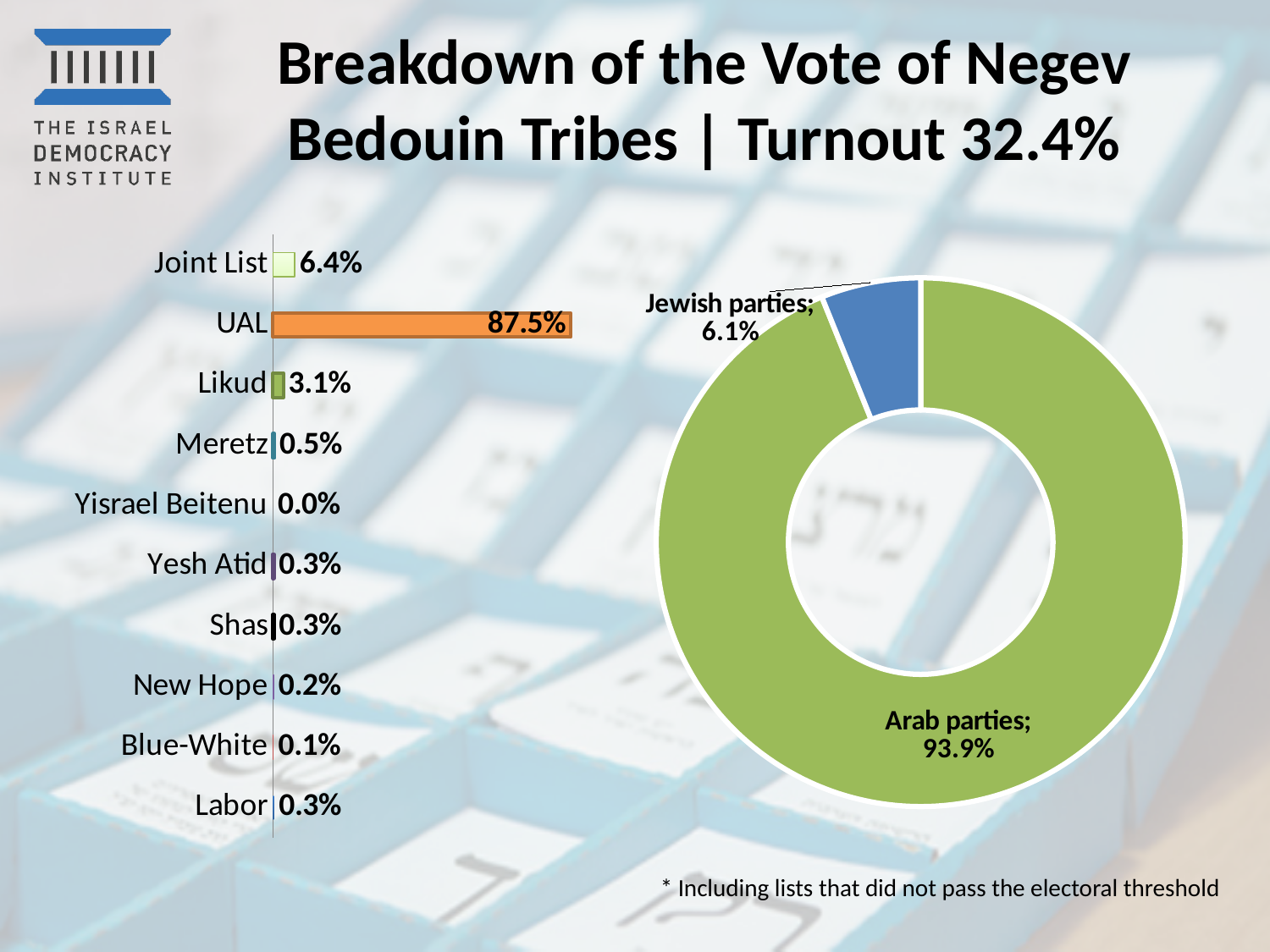
In the donut chart on the right, what share of the vote went to Jewish parties? 6.1% In the bar chart on the left, what is the value for Likud? 3.1% What kind of chart is on the left side of the slide? Bar chart How many parties are shown in the bar chart on the left? 10 What is the turnout figure given in the slide title? 32.4% In the donut chart on the right, what share of the vote went to Arab parties? 93.9% In the bar chart on the left, what is the value for Joint List? 6.4% In the bar chart on the left, what is the value for UAL? 87.5% In the bar chart on the left, what is the difference between the values for UAL and Joint List? 81.1% In the bar chart on the left, which party has the highest value? UAL In the bar chart on the left, which is larger, the value for Likud or the value for Meretz? Likud In the bar chart on the left, which party has the lowest value? Yisrael Beitenu